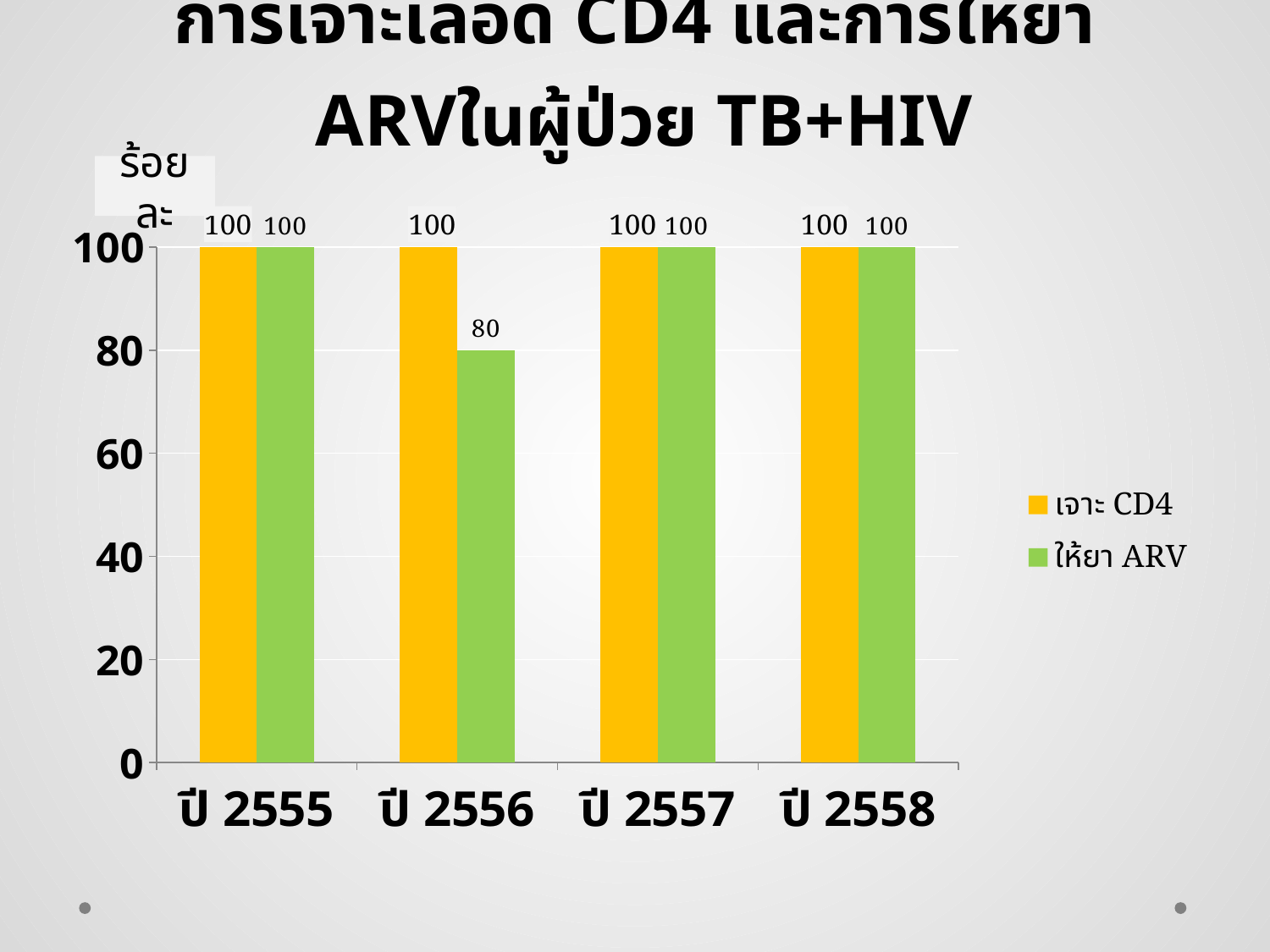
Which series is shown in green in the legend? ให้ยา ARV What kind of chart is shown on the slide? bar chart How many year categories are shown on the x axis? 4 Is the value for ให้ยา ARV in ปี 2556 greater or less than 60? greater In which year is the ให้ยา ARV value lowest? ปี 2556 What is the value for เจาะ CD4 in ปี 2556? 100 What is the difference between เจาะ CD4 and ให้ยา ARV in ปี 2556? 20 In ปี 2556, which is larger: เจาะ CD4 or ให้ยา ARV? เจาะ CD4 What label is shown on the vertical axis? ร้อยละ What is the value for ให้ยา ARV in ปี 2558? 100 What is the value for ให้ยา ARV in ปี 2556? 80 How many series does the legend list? 2